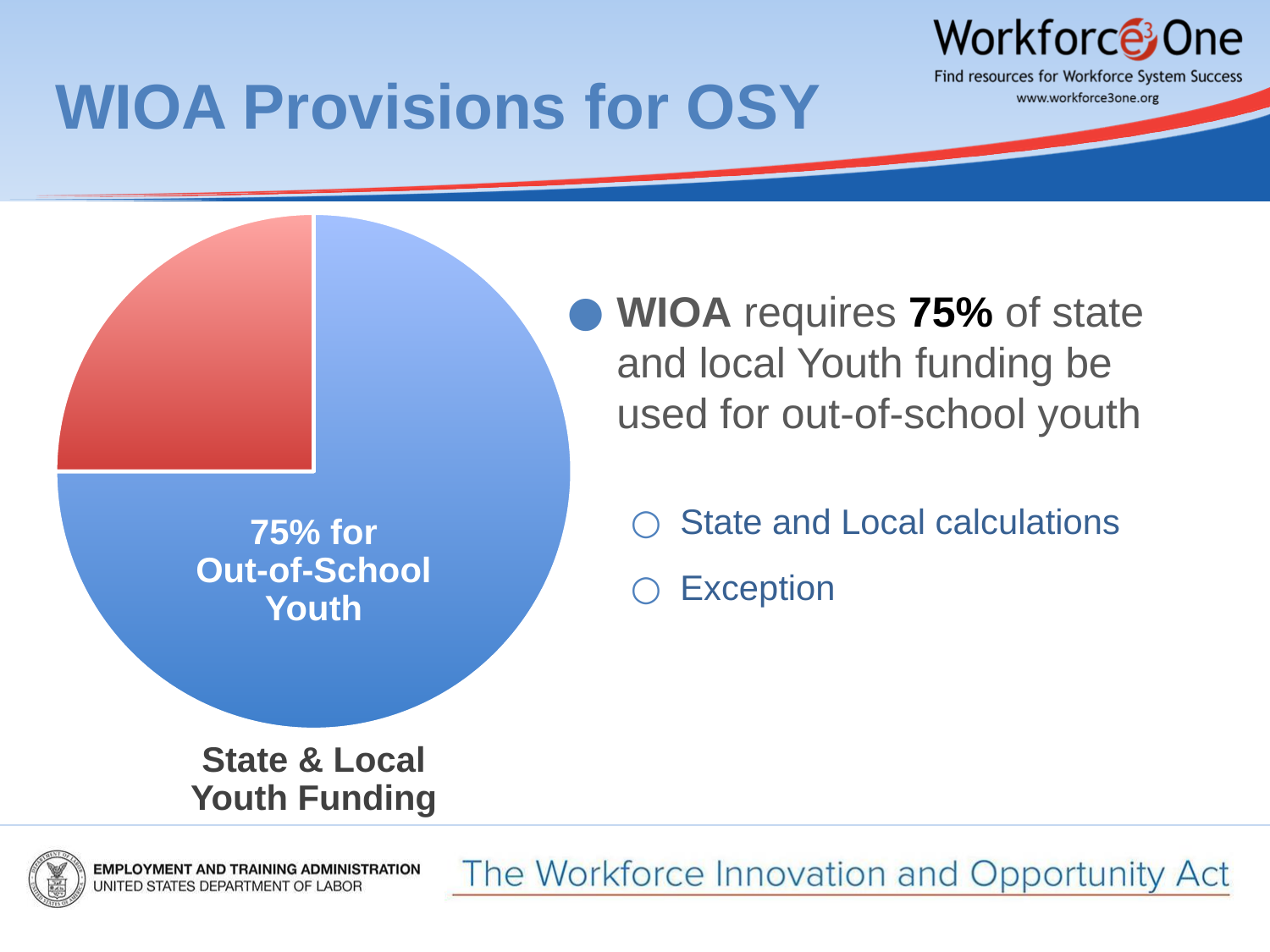
Is the share of the red slice greater or less than 50%? less How many slices does the pie chart have? 2 What kind of chart is shown on the slide? pie chart What colour is the slice labelled '75% for Out-of-School Youth'? blue What is the title of the pie chart? State & Local Youth Funding Which slice of the pie is the largest? 75% for Out-of-School Youth What share of the pie is labelled for Out-of-School Youth? 75% Which slice of the pie is larger, the blue slice or the red slice? the blue slice Is the share of the blue slice greater or less than 50%? greater